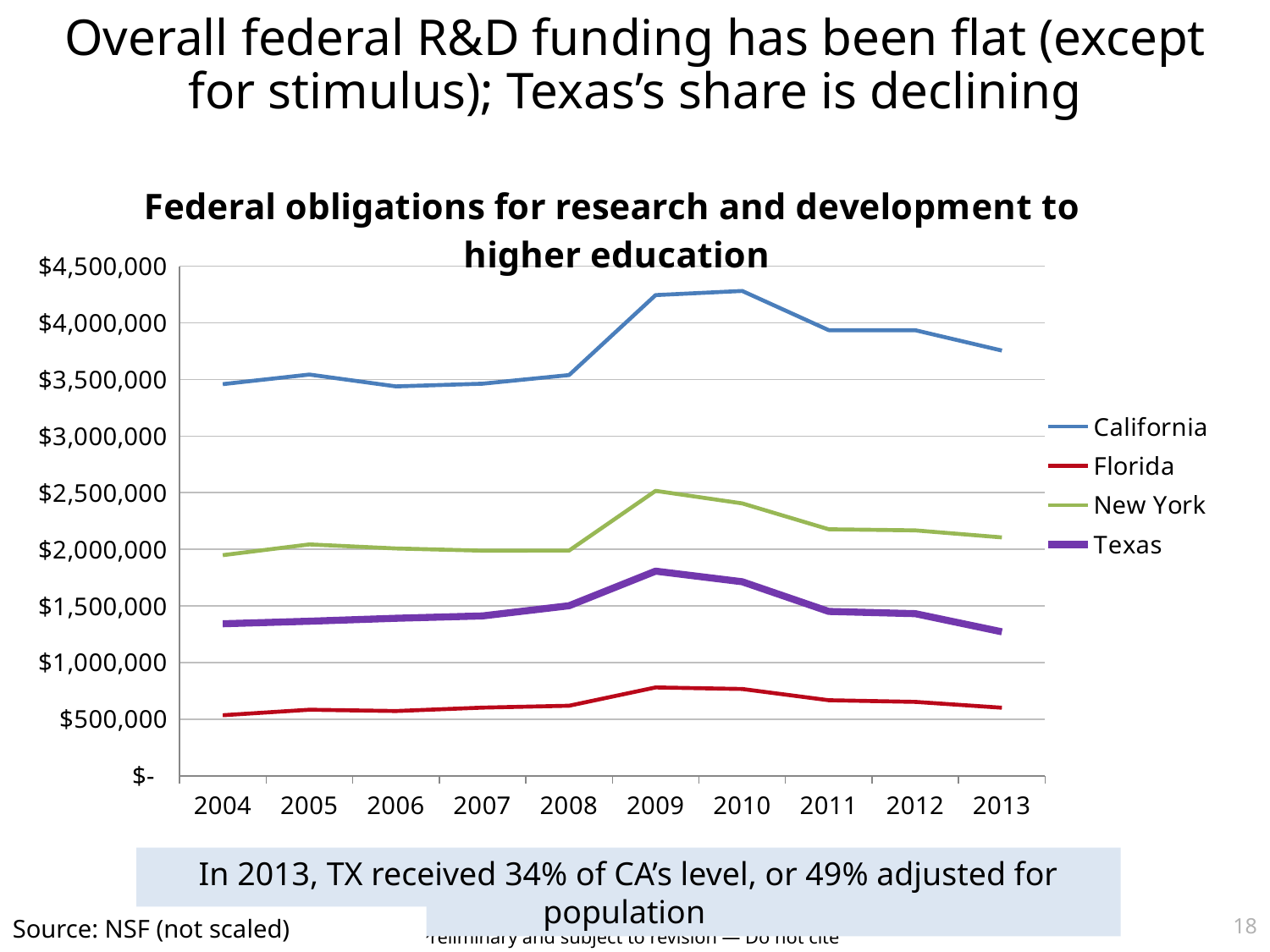
Is the value for Florida in 2009 greater or less than $1,000,000? less How many years are plotted along the x axis? 10 Is the value for California in 2009 greater or less than $4,000,000? greater Which state has the highest federal R&D obligations in 2013? California Do the values for Texas rise or fall from 2009 to 2013? fall Which state has the lowest federal R&D obligations across the years shown? Florida Is the value for Texas in 2013 greater or less than $1,500,000? less How many series does the legend list? 4 Which is larger for Texas: the value in 2009 or the value in 2013? 2009 What kind of chart is shown on the slide? line chart In which year does the Texas line reach its peak? 2009